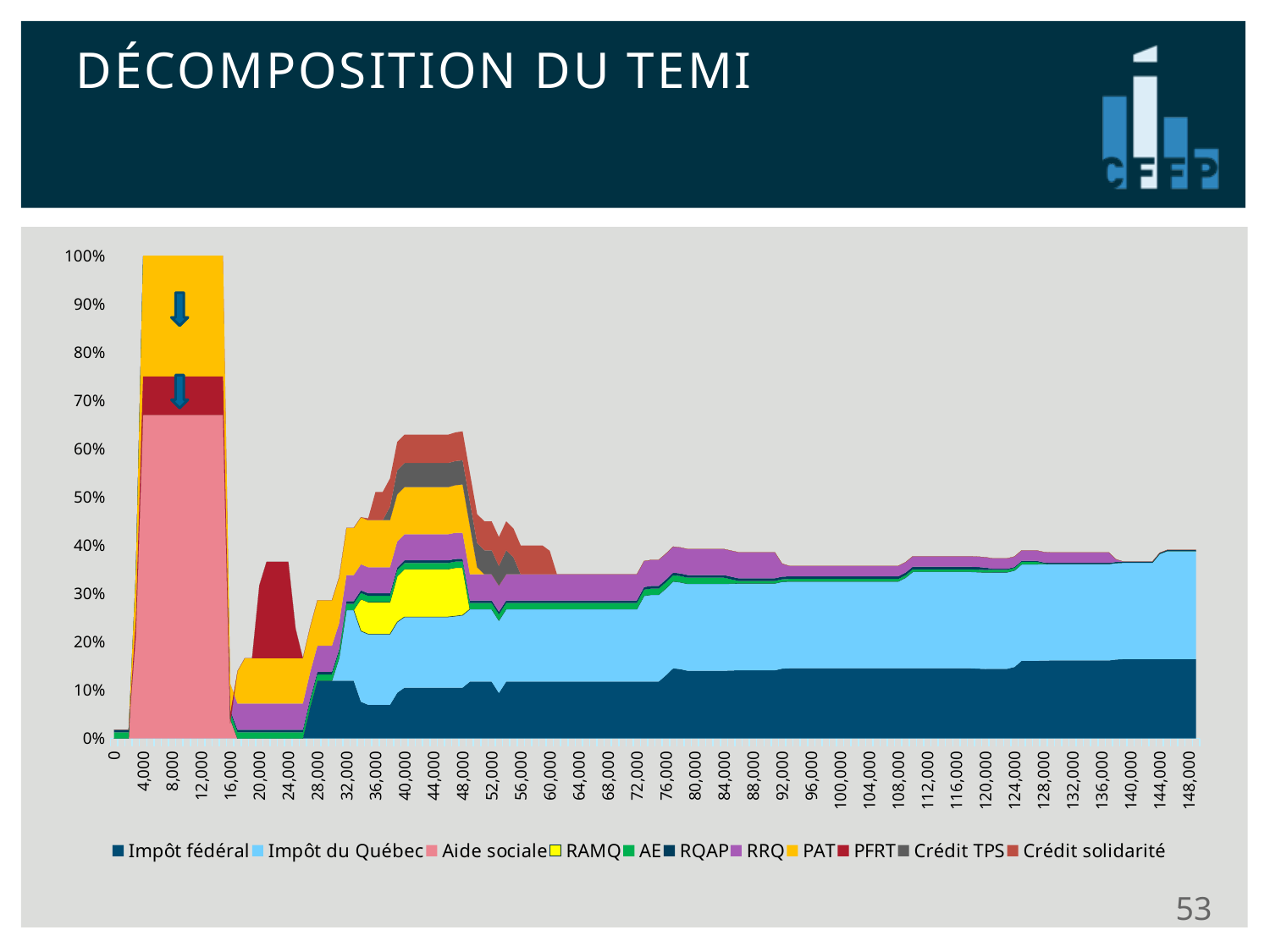
Is the total stacked value larger at an income of 8,000 or at 148,000? 8,000 Is the total stacked value larger at an income of 40,000 or at 100,000? 40,000 Is the total stacked value at an income of 40,000 greater or less than 50%? greater What is the total stacked value at an income of 8,000? 100% Is the total stacked value at an income of 148,000 greater or less than 50%? less What kind of chart is shown on the slide? Stacked area chart What is the highest value shown on the vertical axis? 100% Is the total stacked value at an income of 20,000 greater or less than 50%? less What is the title of the slide containing the chart? DÉCOMPOSITION DU TEMI How many series does the legend list? 11 Which series is shown in yellow in the legend? RAMQ